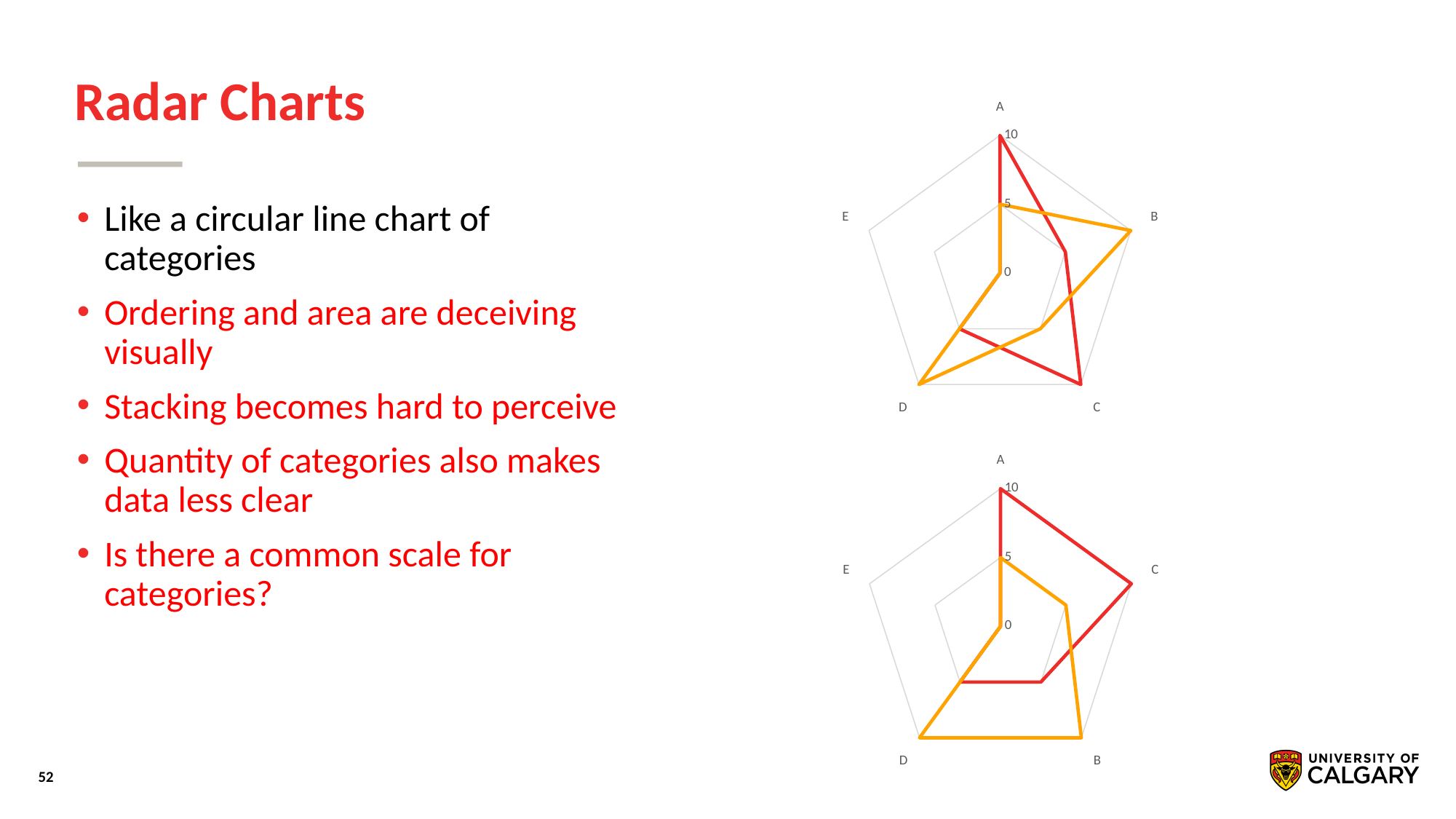
In the bottom radar chart, which line has the larger value for category B, red or orange? orange In the top radar chart, what is the value of the orange line for category B? 10 What is the maximum value shown on the axis scale of the top radar chart? 10 In the bottom radar chart, is the orange line's value for category A greater or less than 10? less What kind of chart is the top chart on the slide? Radar chart In the top radar chart, what is the value of the red line for category E? 0 In the top radar chart, is the red line's value for category C greater or less than 5? greater How many categories does the top radar chart have? 5 In the top radar chart, what is the value of the red line for category A? 10 How many categories does the bottom radar chart have? 5 In the top radar chart, which line has the larger value for category D, red or orange? orange In the bottom radar chart, what is the value of the red line for category C? 10